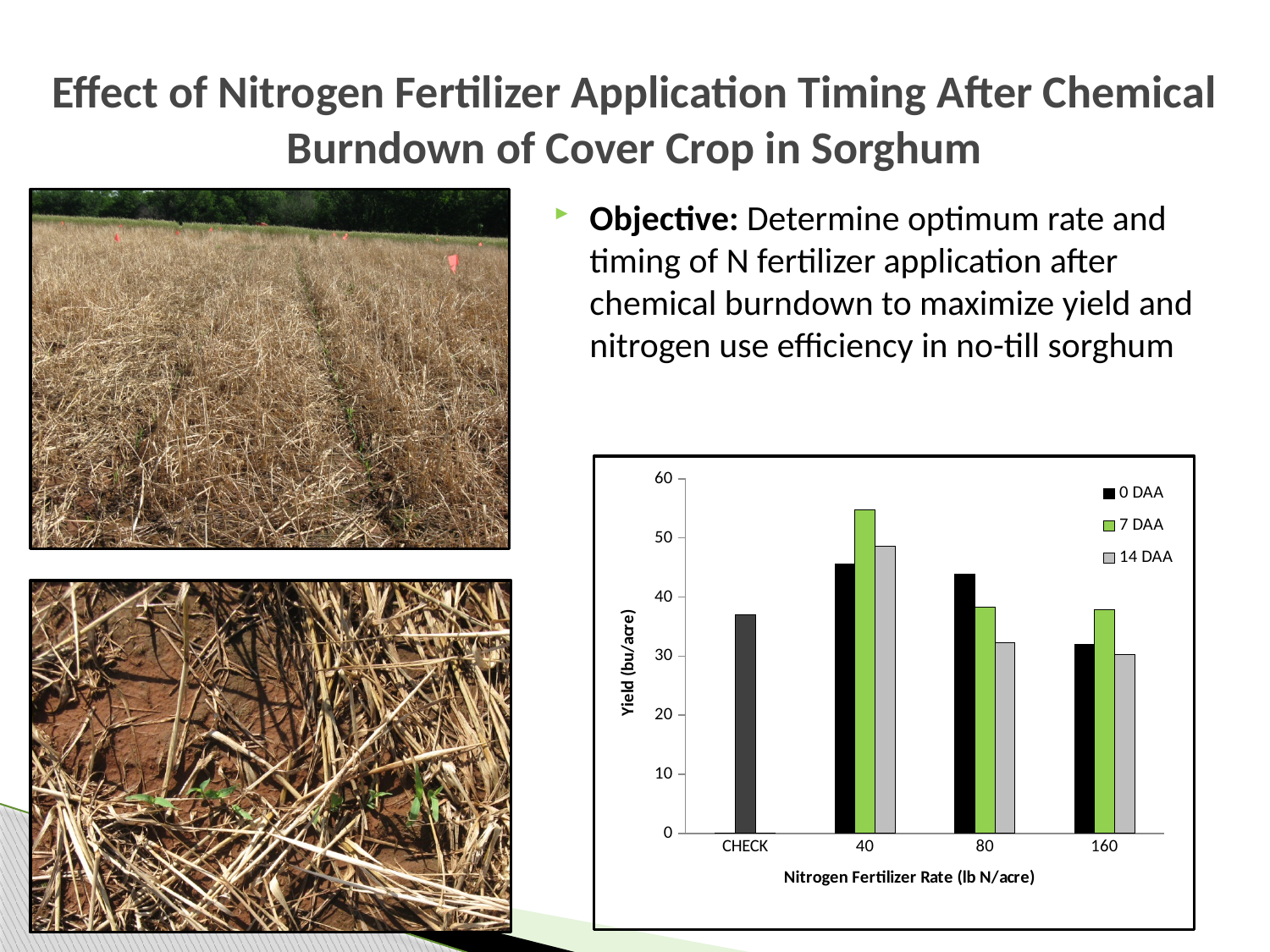
Which series and nitrogen rate has the highest yield bar in the chart? 7 DAA at 40 How many series does the chart legend list? 3 What kind of chart is shown on the slide? bar chart What is the label of the chart's y axis? Yield (bu/acre) Is the yield for 7 DAA at 40 lb N/acre greater or less than 50? greater How many nitrogen fertilizer rate categories are shown on the x axis? 4 At the 80 lb N/acre rate, which is larger: the yield for 0 DAA or for 7 DAA? 0 DAA Is the yield for 14 DAA at 80 lb N/acre greater or less than 40? less At the 80 lb N/acre rate, which series has the lowest yield? 14 DAA At the 40 lb N/acre rate, which series has the lowest yield? 0 DAA At the 160 lb N/acre rate, which is larger: the yield for 0 DAA or for 7 DAA? 7 DAA Is the yield for the CHECK treatment greater or less than 40? less